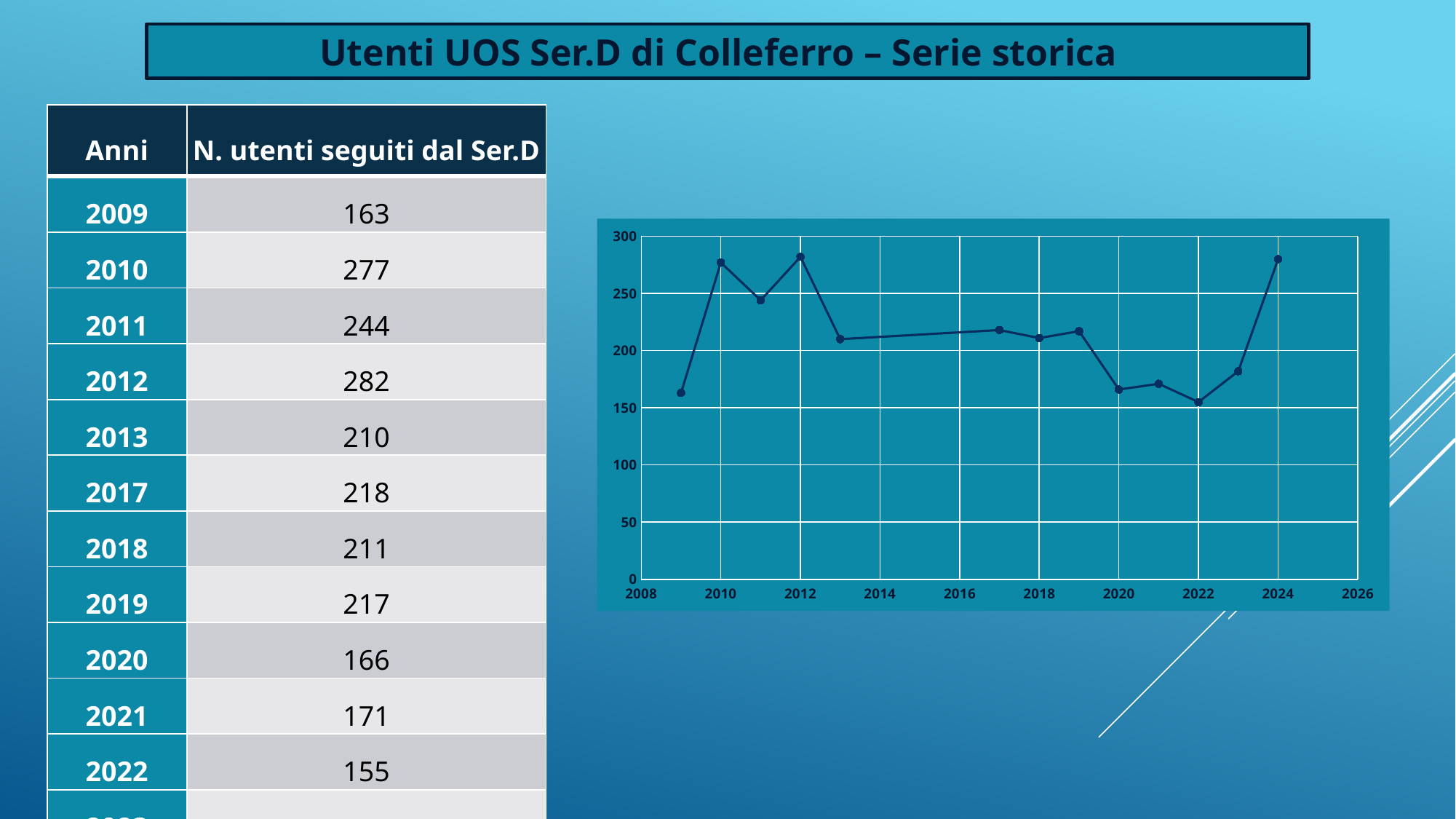
What is the number of users followed by the Ser.D in 2009? 163 What is the number of users followed by the Ser.D in 2020? 166 What is the number of users followed by the Ser.D in 2012? 282 Which year has the lowest number of users on the chart? 2022 What is the difference between the number of users in 2012 and in 2013? 72 Is the value for 2024 on the chart greater or less than 250? greater How many data points are plotted on the line chart? 13 What is the difference between the number of users in 2010 and in 2009? 114 What kind of chart is shown on the slide? line chart What is the title of the slide? Utenti UOS Ser.D di Colleferro – Serie storica Which year has more users, 2011 or 2013? 2011 Do the values rise or fall from 2019 to 2022? fall